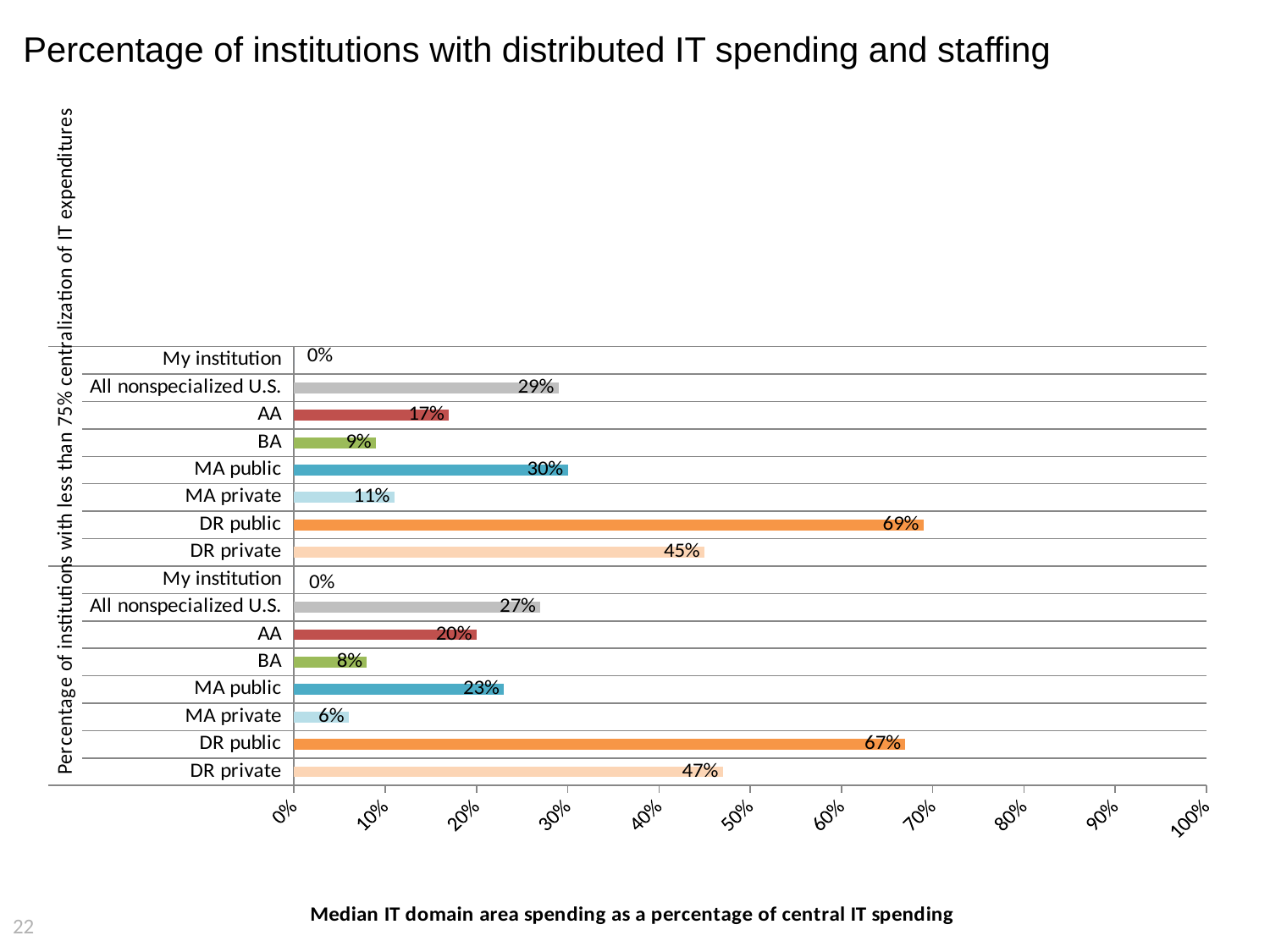
In the lower group of bars, what is the value for MA private? 6% What is the difference between DR public and DR private in the upper group of bars? 24% How many bars are plotted in total on the chart? 16 In the upper group of bars, what is the value for DR public? 69% What is the difference between MA public in the upper group and MA public in the lower group? 7% What type of chart is shown on the slide? Bar chart In the upper group of bars, what is the value for All nonspecialized U.S.? 29% In the lower group of bars, which is larger: AA or MA public? MA public What is the title of the chart? Percentage of institutions with distributed IT spending and staffing In the lower group of bars, what is the value for DR private? 47% In the upper group of bars, which category has the highest value? DR public In the lower group of bars, which category has the lowest value? My institution